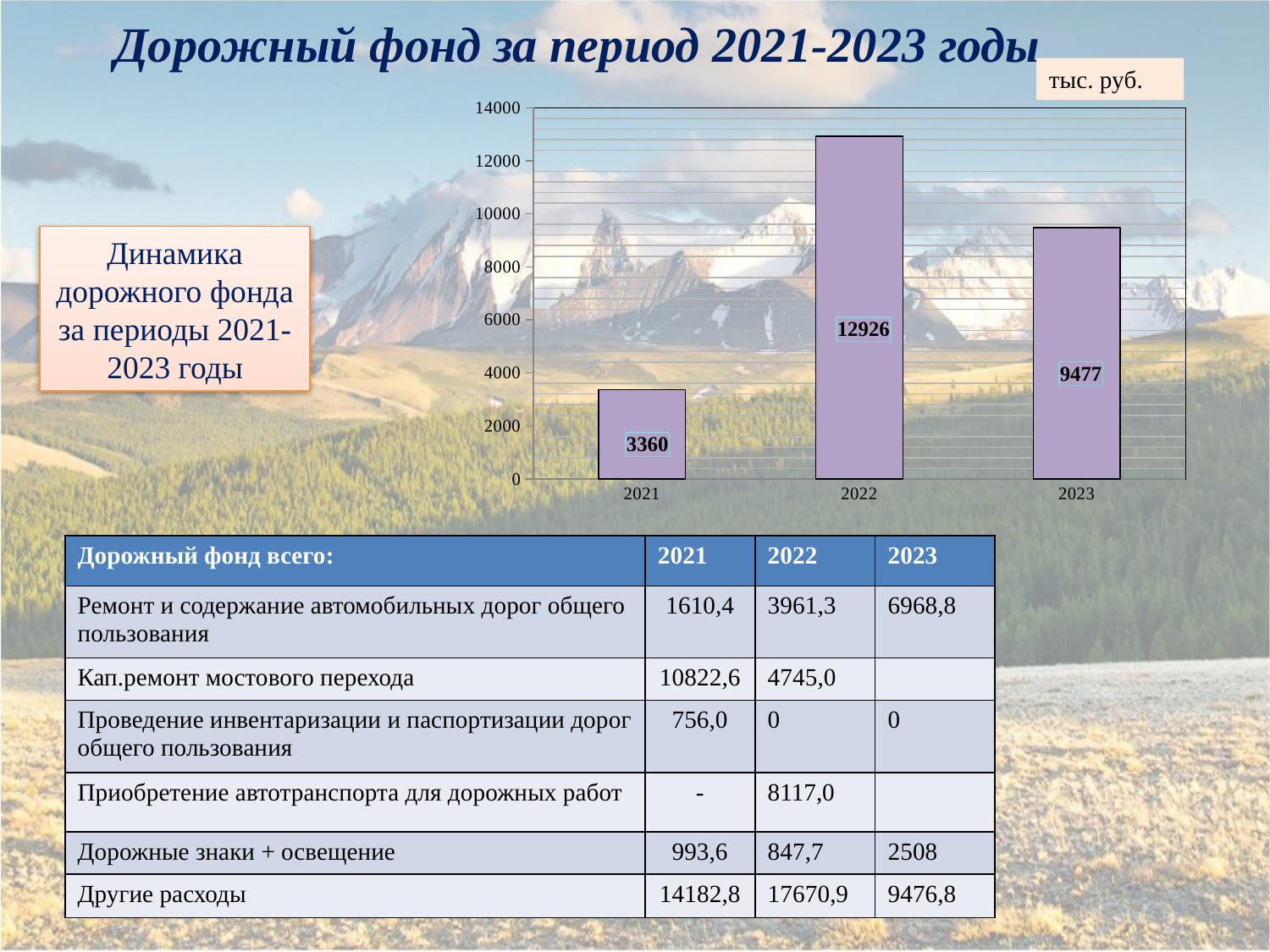
What is the difference between the values for 2022 and 2023? 3449 Which year has the lowest value in the chart? 2021 What is the value for 2022 in the chart? 12926 What unit is indicated for the chart values? тыс. руб. Which is larger, the value for 2023 or the value for 2021? 2023 What is the value for 2023 in the chart? 9477 Which year has the highest value in the chart? 2022 What is the difference between the values for 2022 and 2021? 9566 How many years are shown on the x axis of the chart? 3 Is the value for 2022 greater or less than 12000? greater What is the value for 2021 in the chart? 3360 What kind of chart is shown on the slide? bar chart